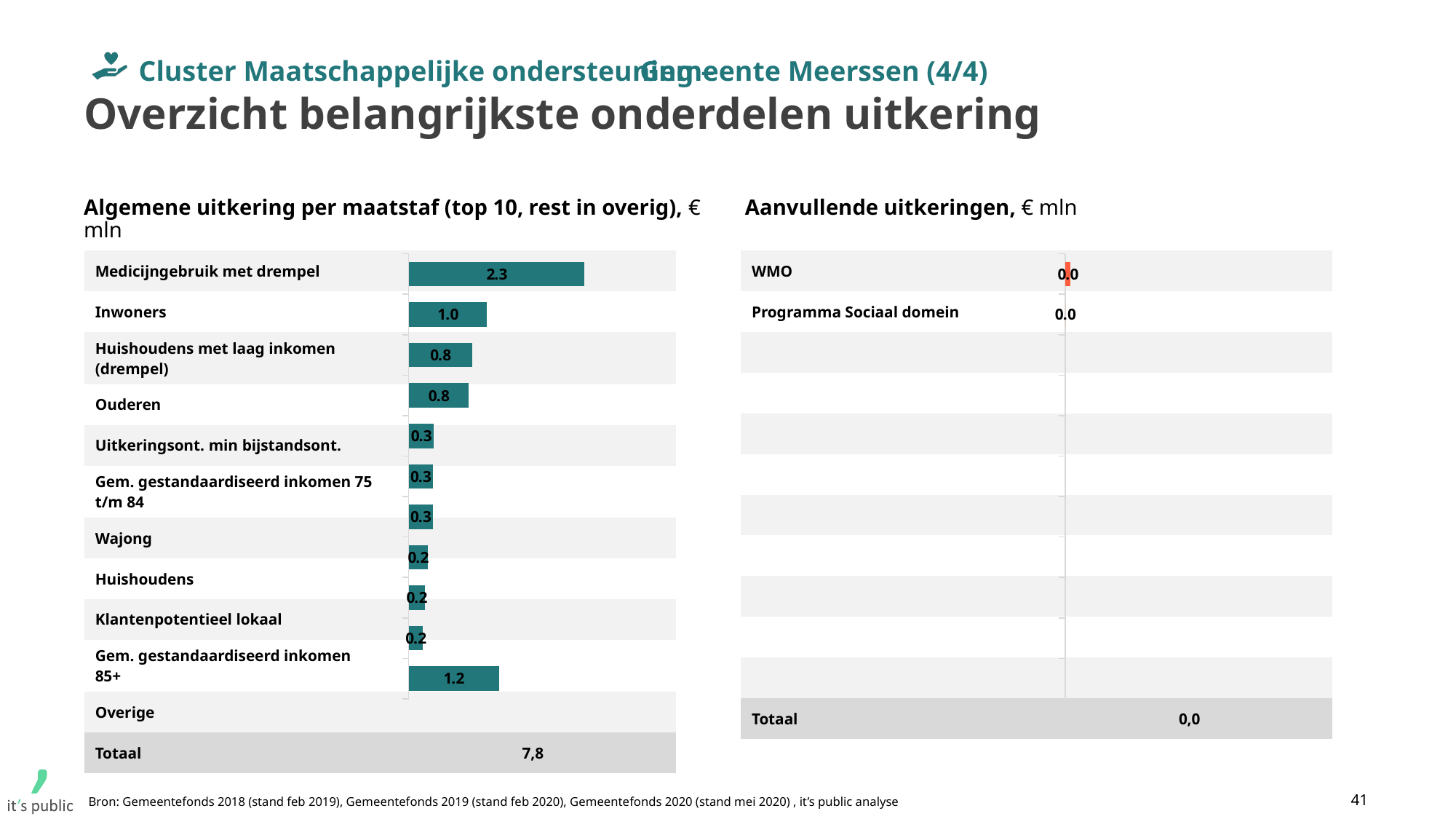
In the left chart (Algemene uitkering per maatstaf), which is larger: Inwoners or Ouderen? Inwoners In the left chart (Algemene uitkering per maatstaf), what is the Totaal shown? 7,8 In the right chart (Aanvullende uitkeringen), what is the Totaal shown? 0,0 In the left chart (Algemene uitkering per maatstaf), what is the value for Ouderen? 0.8 In the right chart (Aanvullende uitkeringen), how many categories are listed (excluding Totaal)? 2 What kind of chart is the left chart (Algemene uitkering per maatstaf)? Bar chart In the left chart (Algemene uitkering per maatstaf), how many categories are plotted (excluding Totaal)? 11 In the left chart (Algemene uitkering per maatstaf), what is the difference between Medicijngebruik met drempel and Inwoners? 1.3 In the right chart (Aanvullende uitkeringen), what is the value for WMO? 0.0 In the left chart (Algemene uitkering per maatstaf), what is the value for Inwoners? 1.0 In the left chart (Algemene uitkering per maatstaf), what is the value for Medicijngebruik met drempel? 2.3 In the left chart (Algemene uitkering per maatstaf), which category has the highest value? Medicijngebruik met drempel